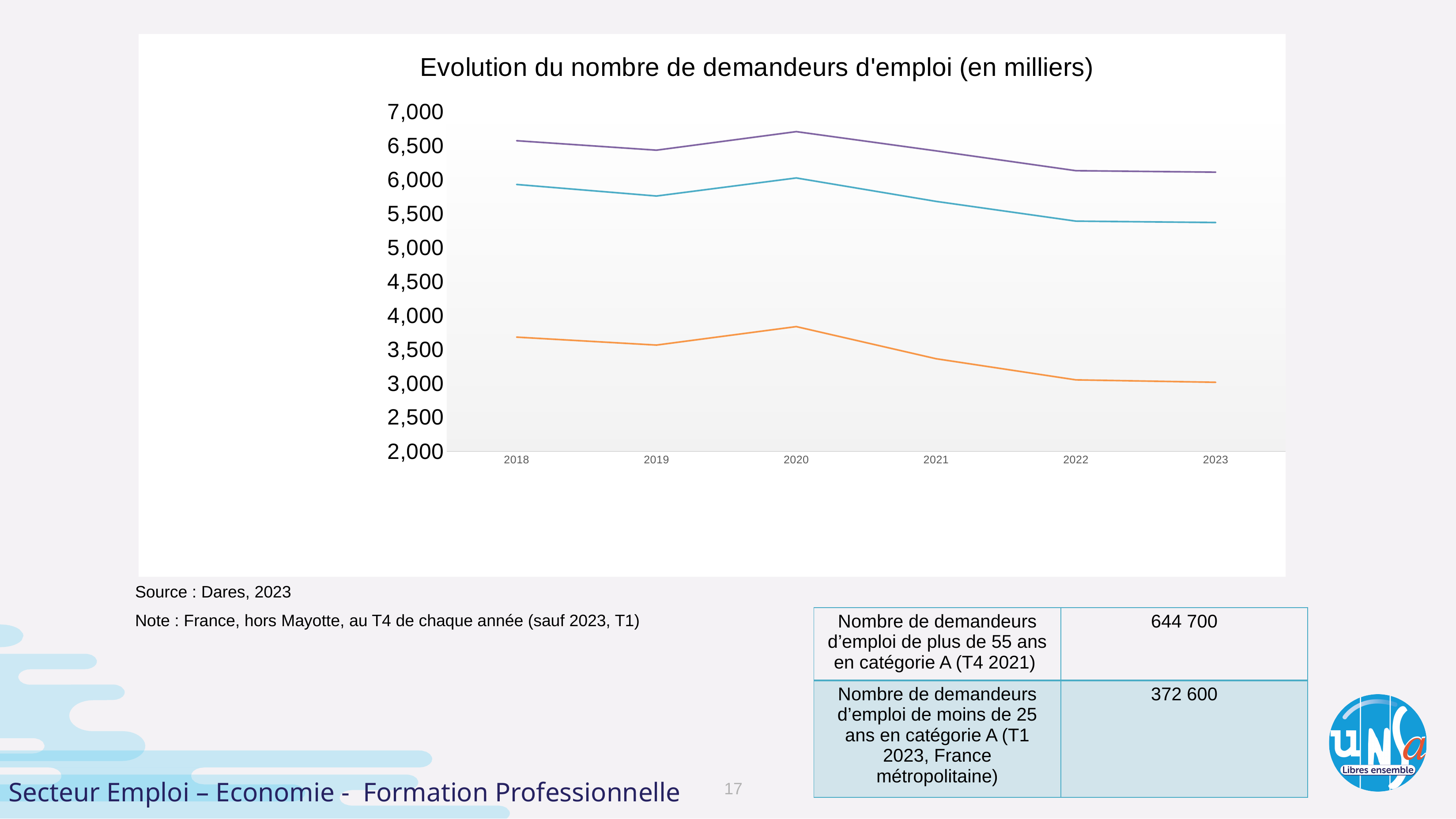
In which year does the orange line reach its highest value? 2020 How many lines are plotted on the chart? 3 Is the value of the orange line in 2020 greater or less than 3,500? greater In which year does the purple line reach its highest value? 2020 What kind of chart is shown on the slide? line chart Do the values of the orange line rise or fall from 2020 to 2023? fall What is the title of the chart? Evolution du nombre de demandeurs d'emploi (en milliers) Is the value of the purple line in 2018 greater or less than 6,500? greater Is the value of the blue line in 2022 greater or less than 5,500? less Which line has the larger value in 2020, the purple line or the orange line? purple line How many years are shown on the x axis of the chart? 6